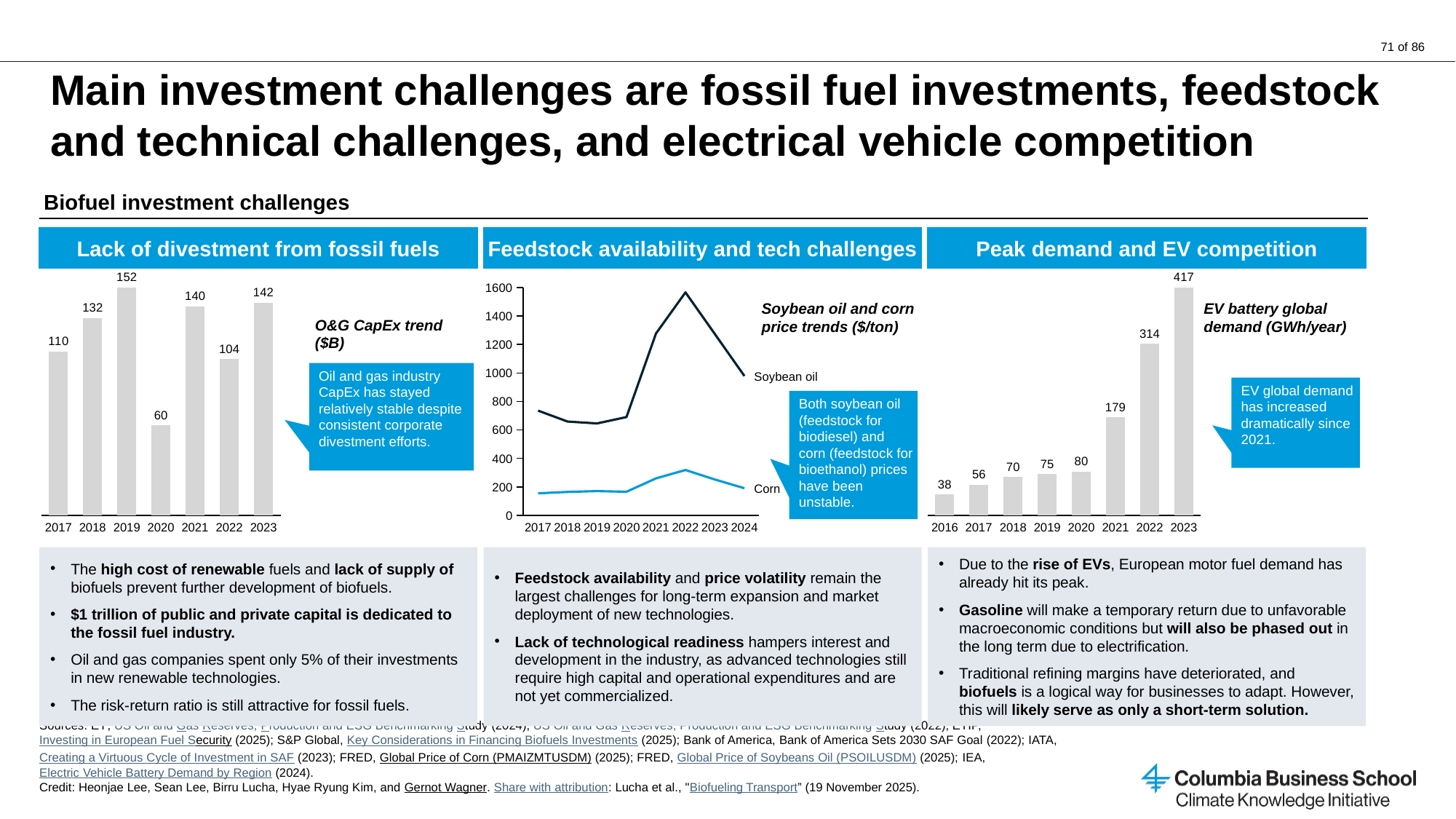
In the O&G CapEx trend ($B) chart, what is the value for 2019? 152 In the EV battery global demand (GWh/year) chart, what is the difference between the 2022 and 2021 values? 135 In the O&G CapEx trend ($B) chart, how many years are plotted? 7 In the O&G CapEx trend ($B) chart, which is larger, the value for 2018 or the value for 2022? 2018 In the EV battery global demand (GWh/year) chart, what is the value for 2023? 417 What kind of chart is the Soybean oil and corn price trends ($/ton) chart? line chart In the O&G CapEx trend ($B) chart, which year has the lowest value? 2020 In the EV battery global demand (GWh/year) chart, which year has the highest value? 2023 In the O&G CapEx trend ($B) chart, what is the difference between the 2019 and 2020 values? 92 In the Soybean oil and corn price trends ($/ton) chart, is the soybean oil value for 2022 greater or less than 1400? greater In the Soybean oil and corn price trends ($/ton) chart, how many series are plotted? 2 In the EV battery global demand (GWh/year) chart, do the values rise or fall from 2016 to 2023? rise